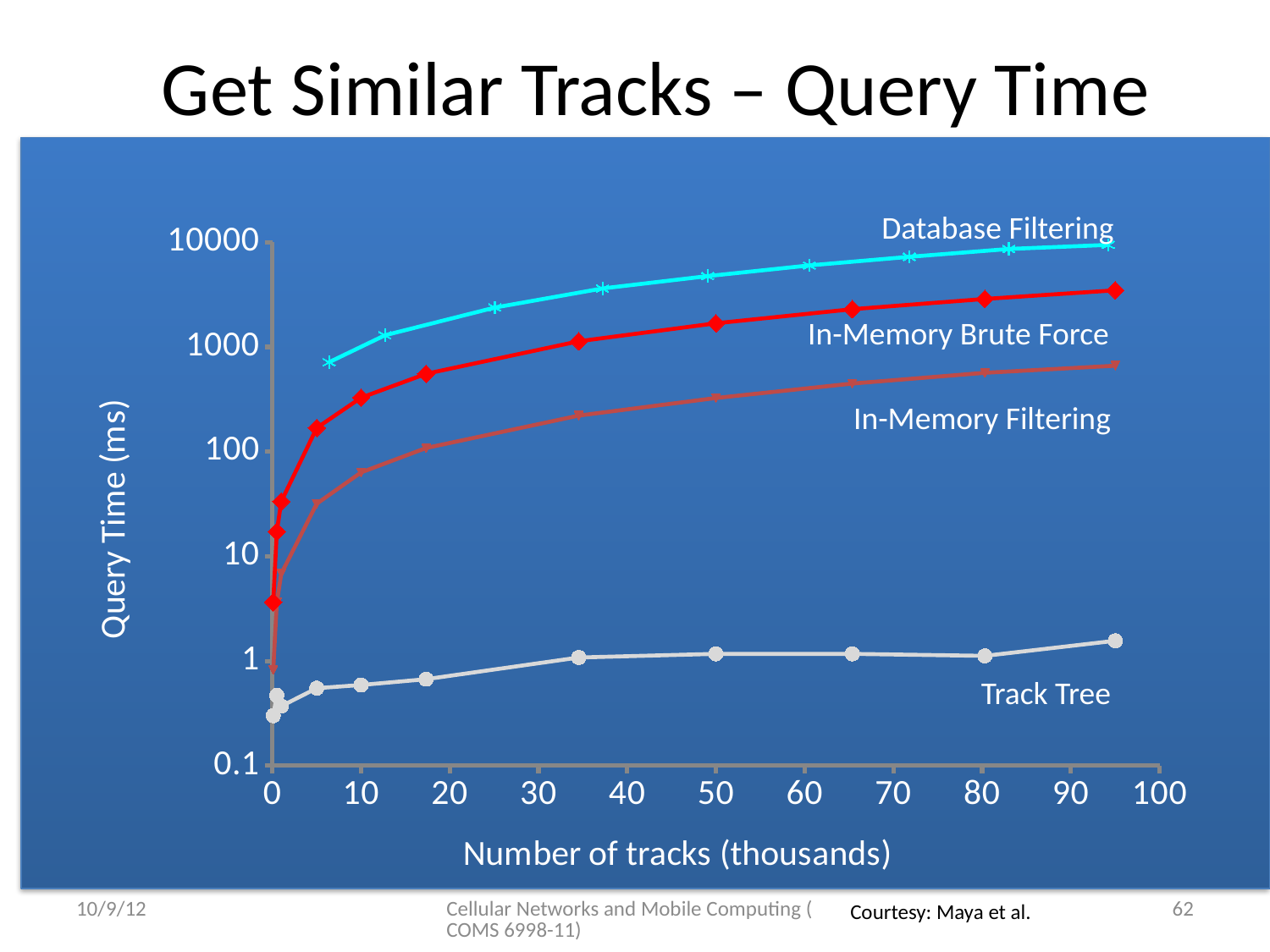
Which series has the lowest query time across the range of track counts? Track Tree Is the query time for Track Tree at 95 thousand tracks greater or less than 10 ms? less Is the query time for In-Memory Brute Force at 10 thousand tracks greater or less than 100 ms? greater Is the query time for In-Memory Filtering at 50 thousand tracks greater or less than 100 ms? greater Which series has the highest query time across the range of track counts? Database Filtering What is the label of the y axis? Query Time (ms) What is the label of the x axis? Number of tracks (thousands) How many series are plotted on the chart? 4 At 50 thousand tracks, which has the larger query time: Database Filtering or Track Tree? Database Filtering What kind of chart is shown on the slide? line chart Does the query time for In-Memory Brute Force rise or fall as the number of tracks increases? rise